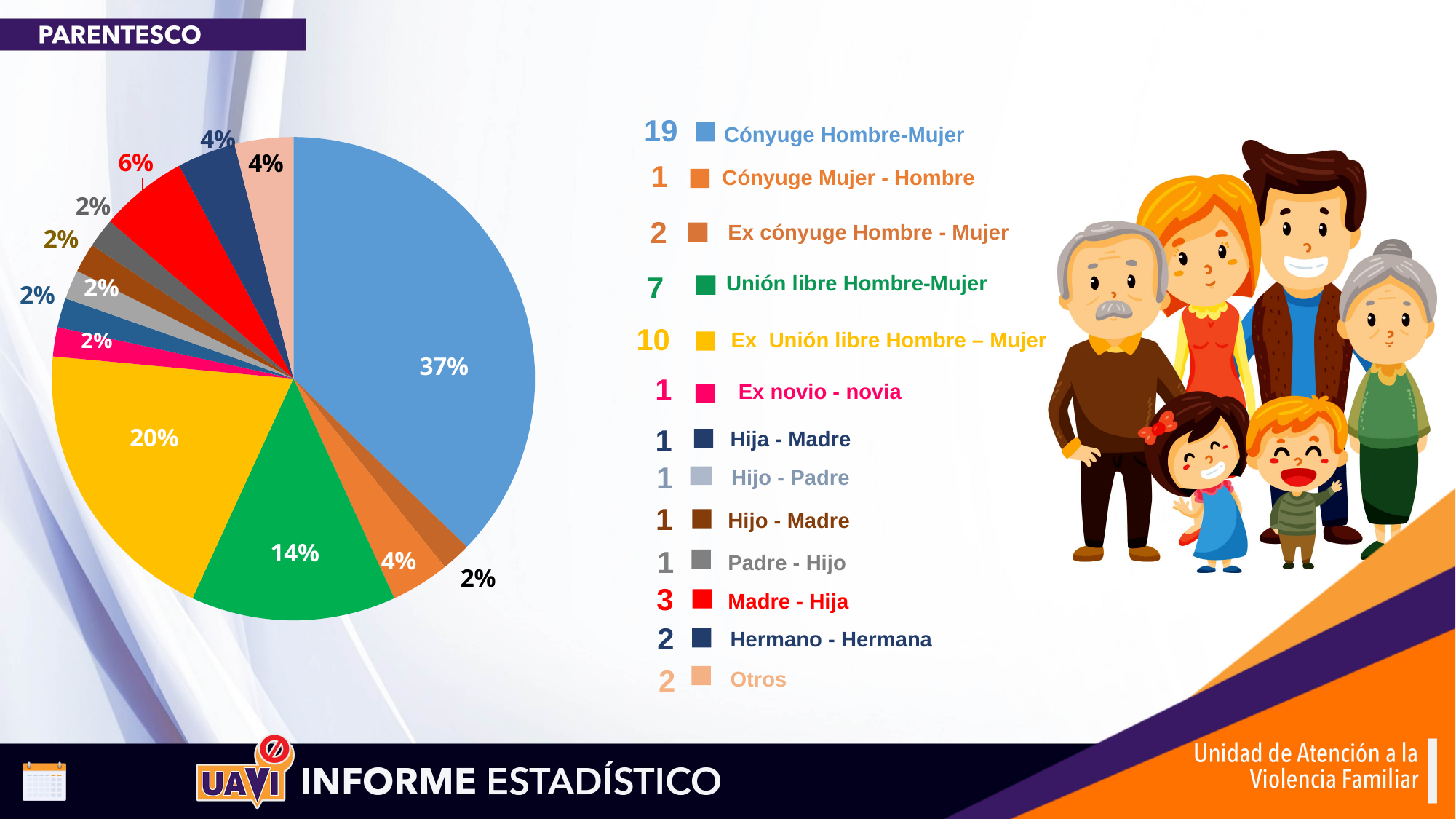
What kind of chart is shown on the slide? pie chart What is the title shown above the pie chart? PARENTESCO What percentage of the pie does Cónyuge Hombre-Mujer represent? 37% What count is shown in the legend for Unión libre Hombre-Mujer? 7 What percentage of the pie does Ex Unión libre Hombre – Mujer represent? 20% What is the difference between the counts for Cónyuge Hombre-Mujer and Unión libre Hombre-Mujer? 12 How many categories does the pie chart legend list? 13 What count is shown in the legend for Ex Unión libre Hombre – Mujer? 10 Which has a larger count, Cónyuge Hombre-Mujer or Ex Unión libre Hombre – Mujer? Cónyuge Hombre-Mujer Which category has the largest share of the pie chart? Cónyuge Hombre-Mujer What count is shown in the legend for Madre - Hija? 3 What percentage of the pie does Unión libre Hombre-Mujer represent? 14%